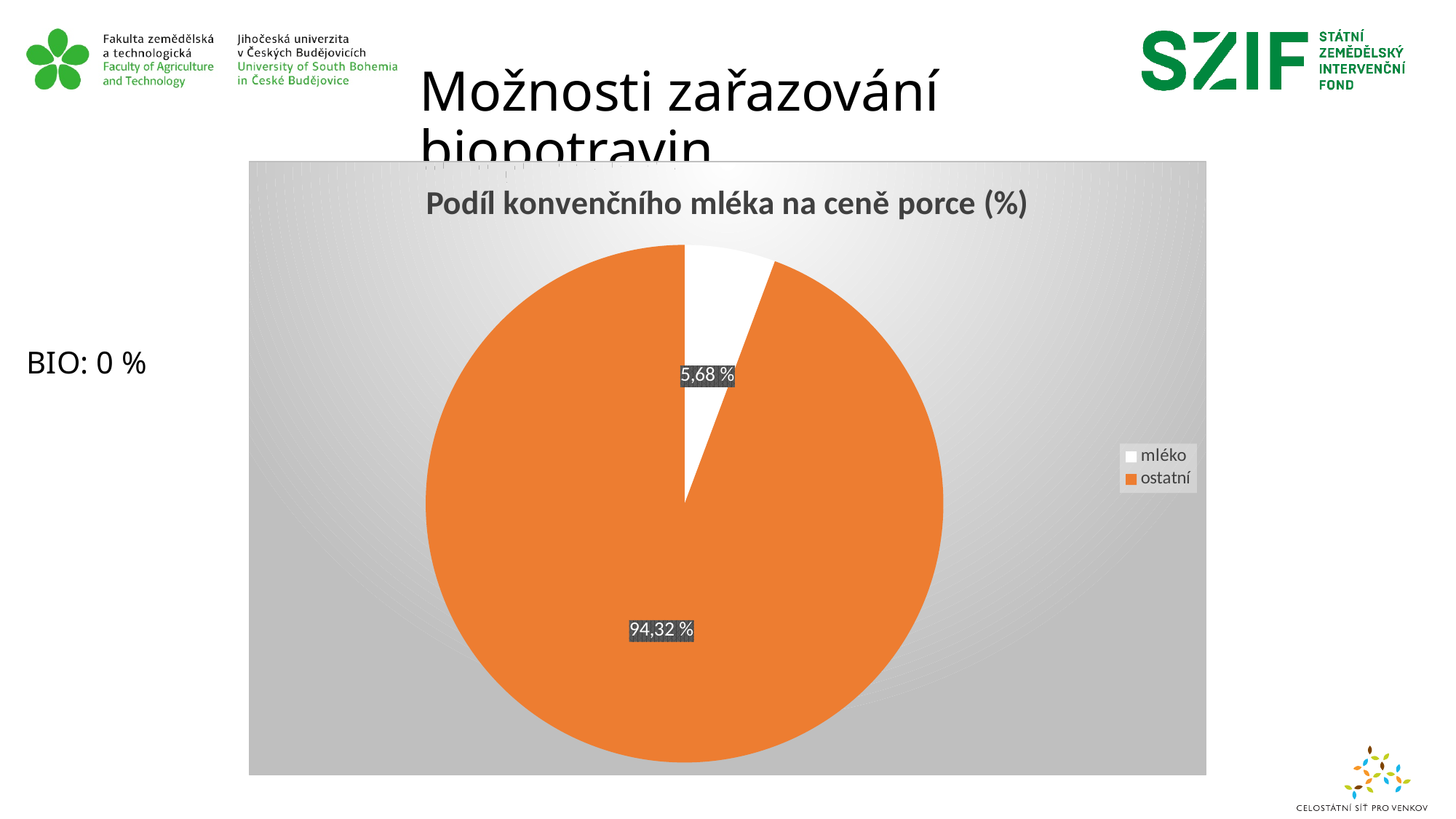
Which slice is the largest? ostatní What is the chart's title? Podíl konvenčního mléka na ceně porce (%) What is the difference between the ostatní and mléko values? 88,64 % How many entries does the legend list? 2 Which is larger, mléko or ostatní? ostatní Which slice is the smallest? mléko What kind of chart is shown on the slide? pie chart What colour is the ostatní slice? orange How many slices does the pie chart have? 2 What is the value for mléko? 5,68 % What is the value for ostatní? 94,32 % What share of the pie does mléko take? 5,68 %